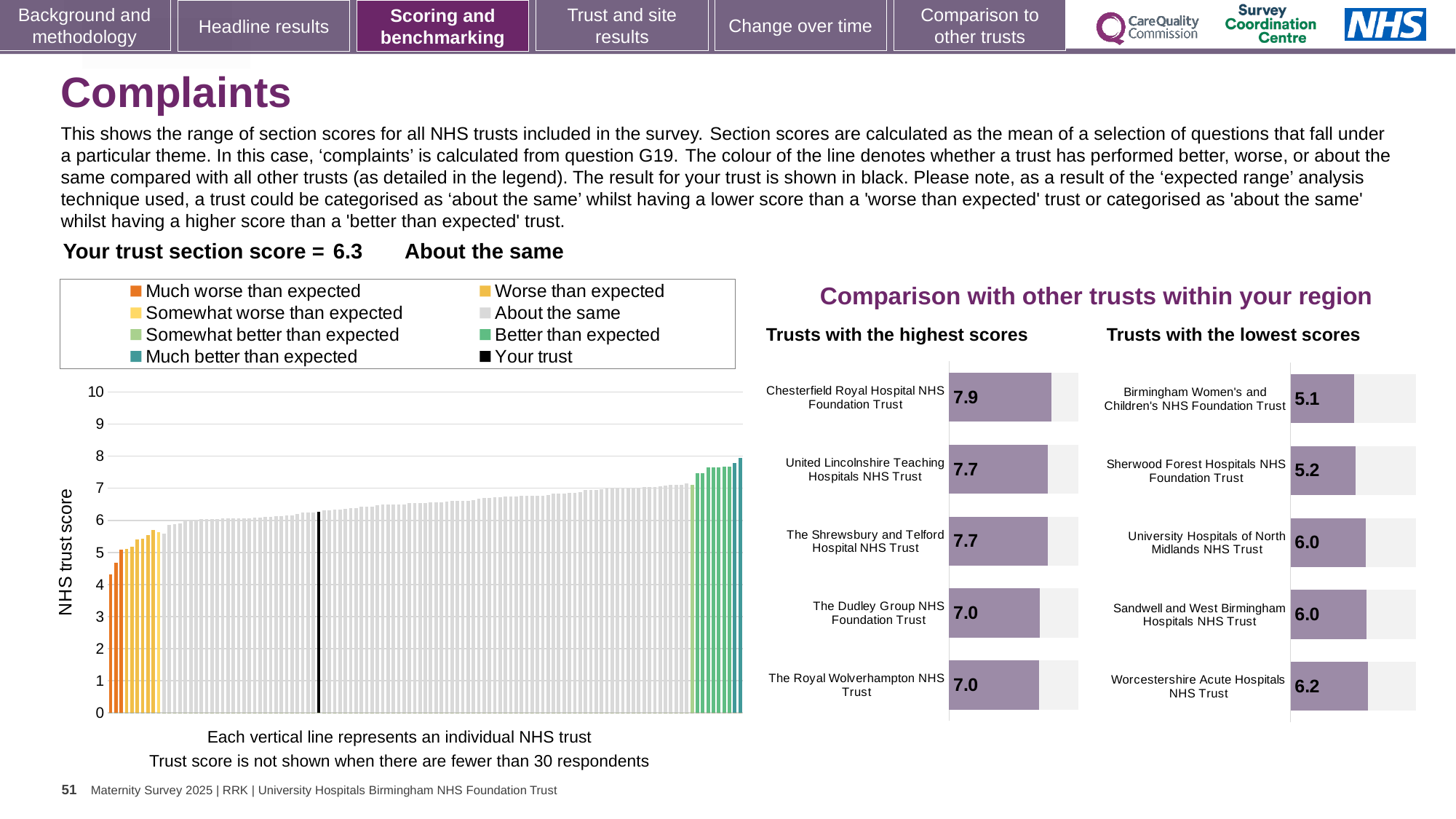
In the 'Trusts with the lowest scores' chart, what is the score for Sherwood Forest Hospitals NHS Foundation Trust? 5.2 How many entries does the legend above the main 'NHS trust score' chart list? 8 In the main 'NHS trust score' chart on the left, do the bars rise or fall from left to right? rise In the 'Trusts with the lowest scores' chart, which trust has the lowest score? Birmingham Women's and Children's NHS Foundation Trust What is the section score for your trust shown on the slide? 6.3 What kind of chart is the main 'NHS trust score' chart on the left? bar chart How many trusts are listed in the 'Trusts with the lowest scores' chart? 5 In the 'Trusts with the highest scores' chart, what is the score for Chesterfield Royal Hospital NHS Foundation Trust? 7.9 In the 'Trusts with the highest scores' chart, what is the difference between the scores of Chesterfield Royal Hospital NHS Foundation Trust and The Dudley Group NHS Foundation Trust? 0.9 In the 'Trusts with the highest scores' chart, which trust has the highest score? Chesterfield Royal Hospital NHS Foundation Trust In the 'Trusts with the lowest scores' chart, which has the larger score: Worcestershire Acute Hospitals NHS Trust or Sherwood Forest Hospitals NHS Foundation Trust? Worcestershire Acute Hospitals NHS Trust In the main 'NHS trust score' chart on the left, is the value of the leftmost bar greater or less than 5? less